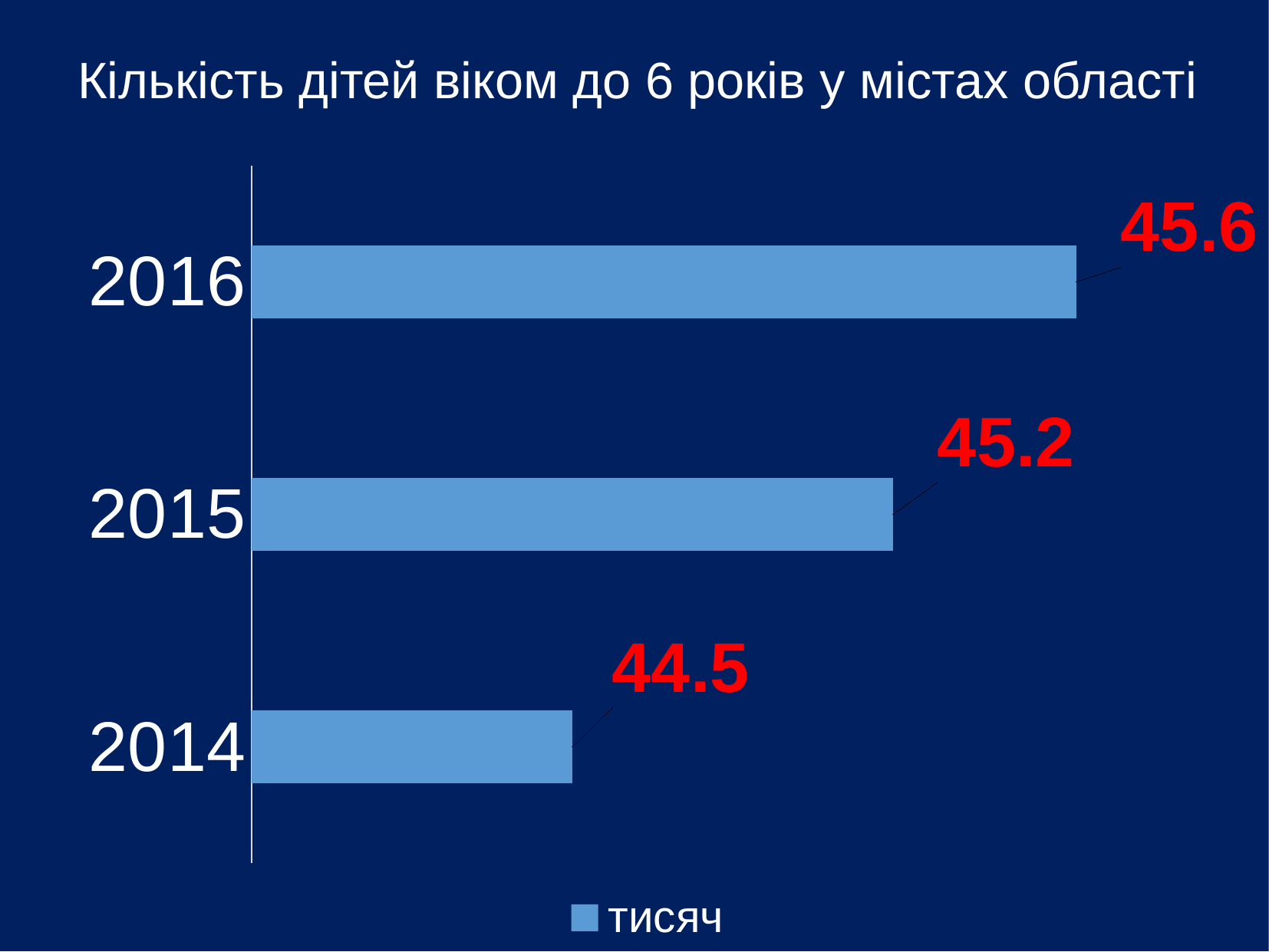
How many years are shown in the chart? 3 What is the value for 2016? 45.6 Which year has the highest value? 2016 How many series does the legend list? 1 What is the value for 2015? 45.2 What is the difference between the values for 2015 and 2014? 0.7 Which is larger, the value for 2015 or the value for 2014? 2015 What is the value for 2014? 44.5 What is the legend entry of the chart? тисяч Which year has the lowest value? 2014 What is the difference between the values for 2016 and 2014? 1.1 What kind of chart is shown on the slide? bar chart